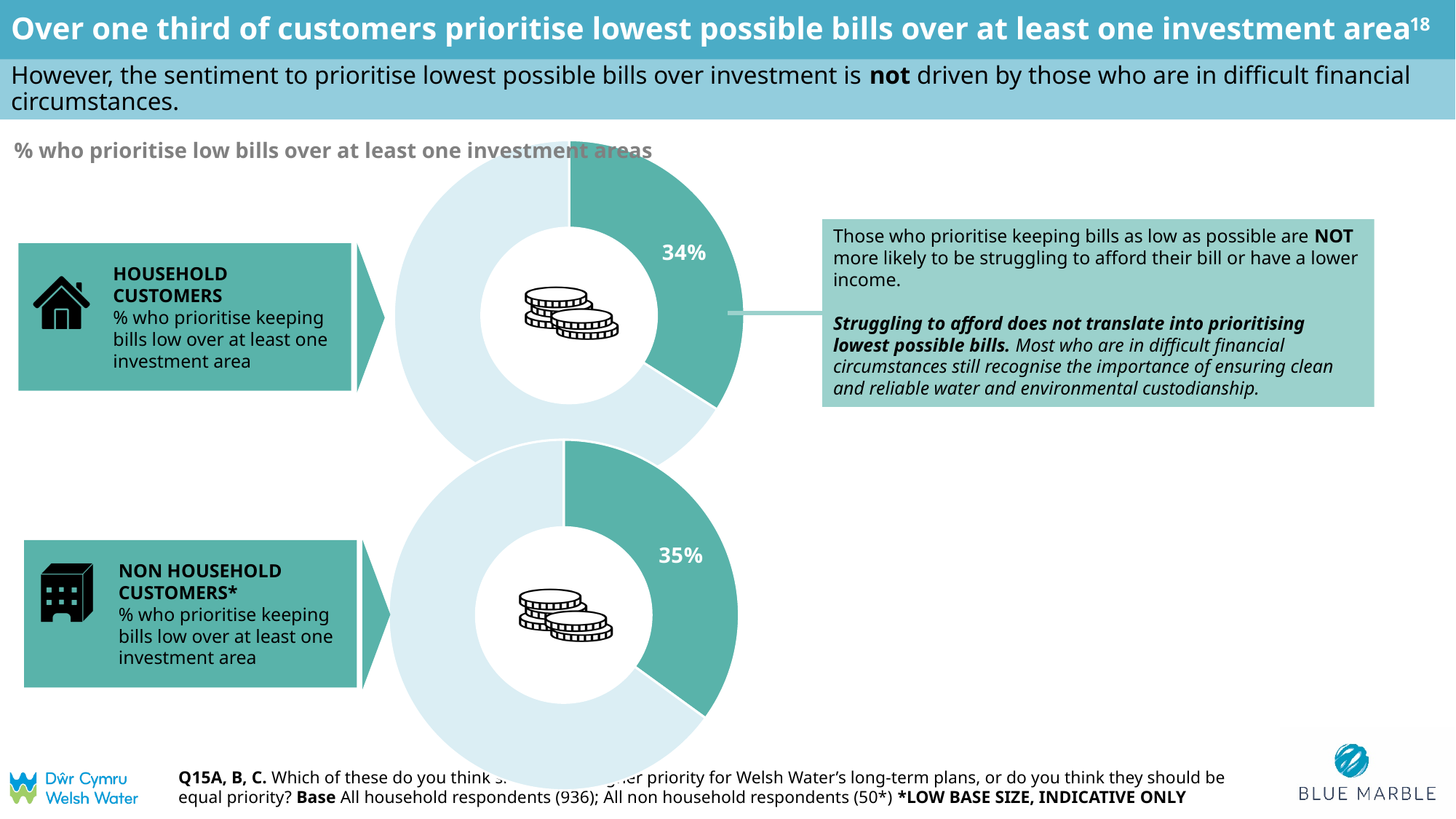
What icon appears in the centre of each donut chart? Stacks of coins On the non household customers chart, what share of the donut does the highlighted (dark teal) slice represent? 35% Which group has the higher share prioritising low bills over at least one investment area, household customers or non household customers? Non household customers What kind of chart is used to show the household customers figure? Donut (pie) chart On the household customers chart, what percentage prioritise keeping bills low over at least one investment area? 34% On the non household customers chart, what percentage prioritise keeping bills low over at least one investment area? 35% Which chart is positioned at the top of the slide, household customers or non household customers? Household customers On the household customers chart, what share of the donut does the highlighted (dark teal) slice represent? 34% What is the difference in percentage points between the non household customers value (35%) and the household customers value (34%)? 1 percentage point What is the title printed above the charts? % who prioritise low bills over at least one investment areas How many donut charts are shown on the slide? 2